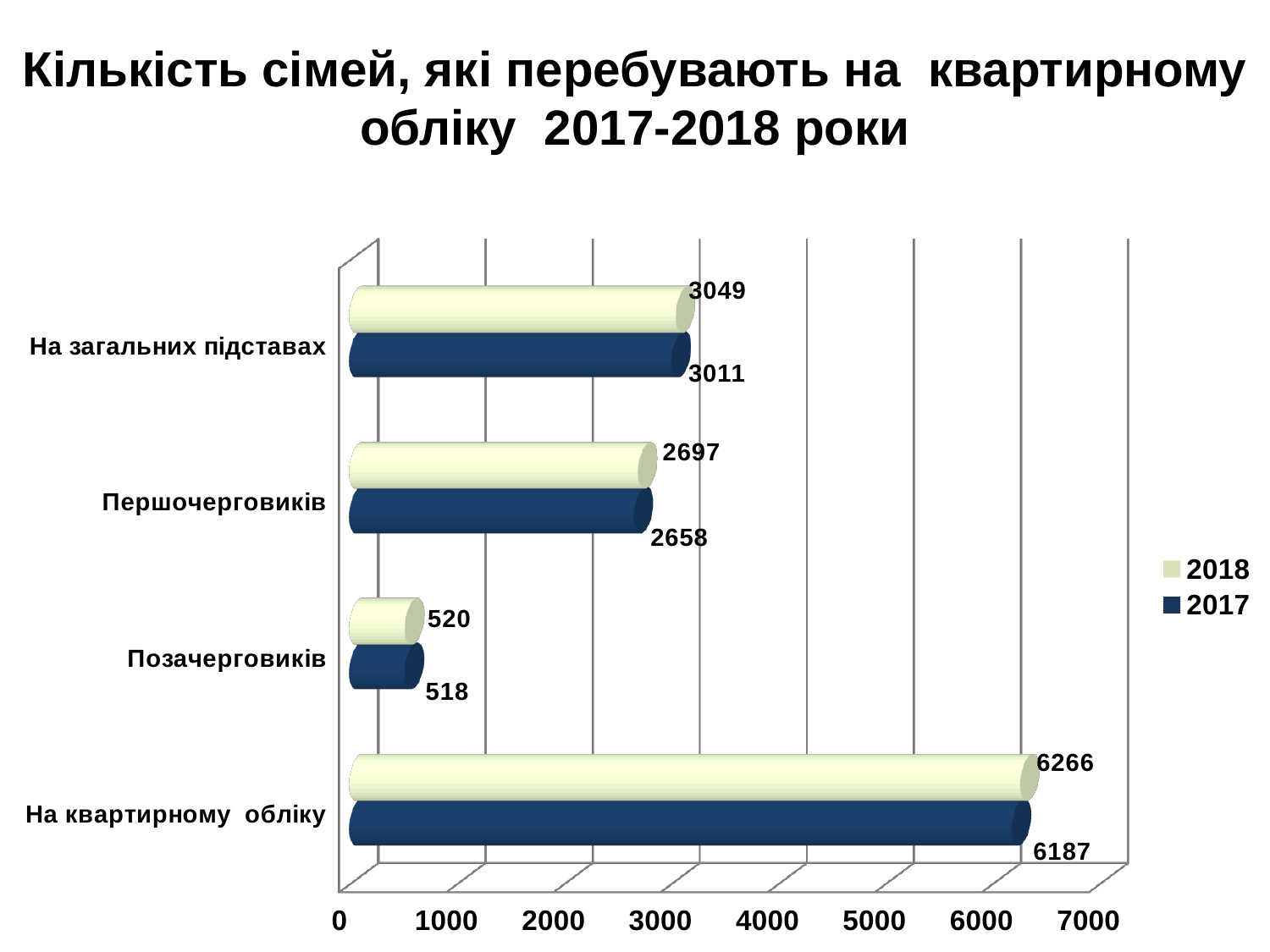
What is the difference between the 2018 and 2017 values for 'Першочерговиків'? 39 What is the difference between the 2018 and 2017 values for 'На квартирному обліку'? 79 Which category has the highest value in 2018? На квартирному обліку Which category has the lowest value in 2017? Позачерговиків What kind of chart is shown on the slide? Bar chart What is the value for 'Першочерговиків' in 2018? 2697 How many categories are shown on the chart? 4 Which is larger: the 2018 value for 'На загальних підставах' or the 2018 value for 'Першочерговиків'? На загальних підставах What is the value for 'Позачерговиків' in 2017? 518 How many series does the legend list? 2 What is the value for 'На загальних підставах' in 2017? 3011 What is the value for 'На квартирному обліку' in 2018? 6266